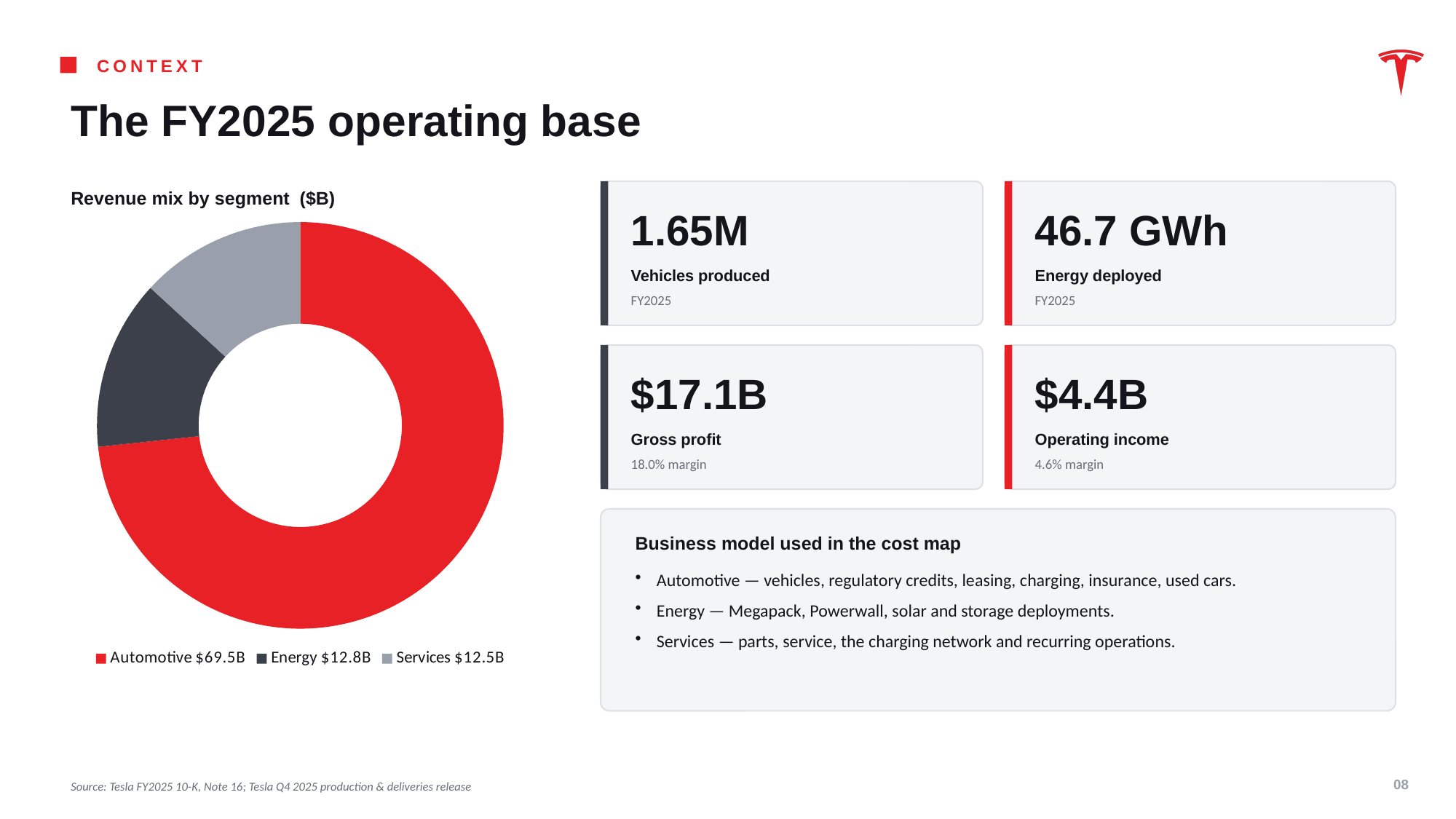
What is the revenue for the Automotive segment in the revenue mix chart? $69.5B What type of chart is used for the revenue mix by segment? doughnut chart What is the difference between Automotive and Energy revenue in the revenue mix chart? $56.7B In the revenue mix chart, which is larger: Energy or Services revenue? Energy Which segment has the largest share of the revenue mix chart? Automotive What is the revenue for the Energy segment in the revenue mix chart? $12.8B What is the title of the chart on the slide? Revenue mix by segment ($B) What is the revenue for the Services segment in the revenue mix chart? $12.5B How many segments are shown in the revenue mix chart? 3 What is the difference between Energy and Services revenue in the revenue mix chart? $0.3B What is the total revenue across all three segments in the revenue mix chart? $94.8B Which segment has the smallest revenue in the revenue mix chart? Services